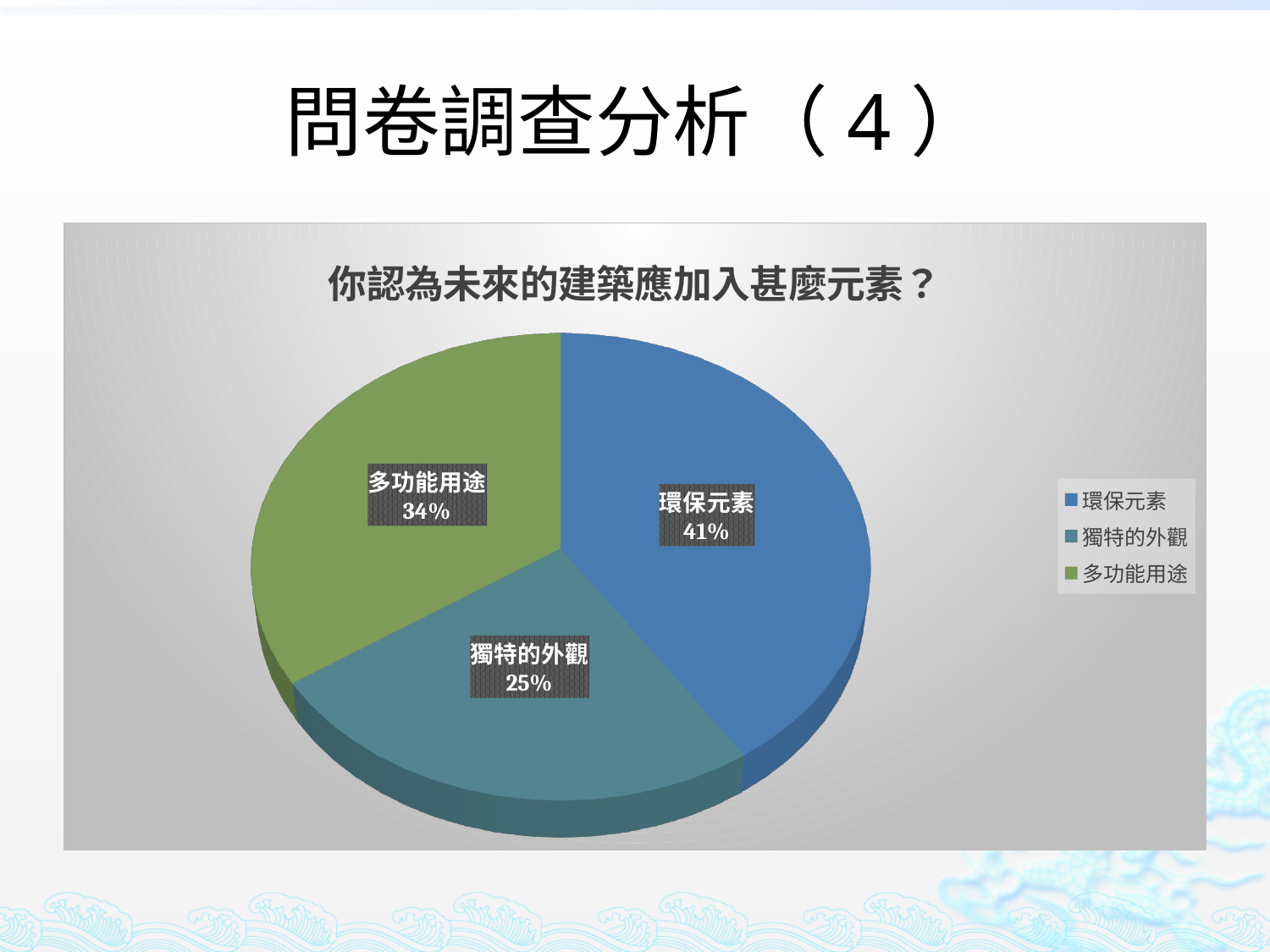
How many slices does the pie chart have? 3 Which category has the smallest share of the pie? 獨特的外觀 What is the title of the chart? 你認為未來的建築應加入甚麼元素？ What percentage is shown for 環保元素? 41% Which category has the largest share of the pie? 環保元素 How many entries does the legend list? 3 What kind of chart is shown on the slide? pie chart Which is larger, the share for 多功能用途 or the share for 獨特的外觀? 多功能用途 What percentage is shown for 獨特的外觀? 25% What percentage is shown for 多功能用途? 34% Which colour represents 多功能用途 in the chart? green What is the difference in percentage points between 環保元素 and 獨特的外觀? 16